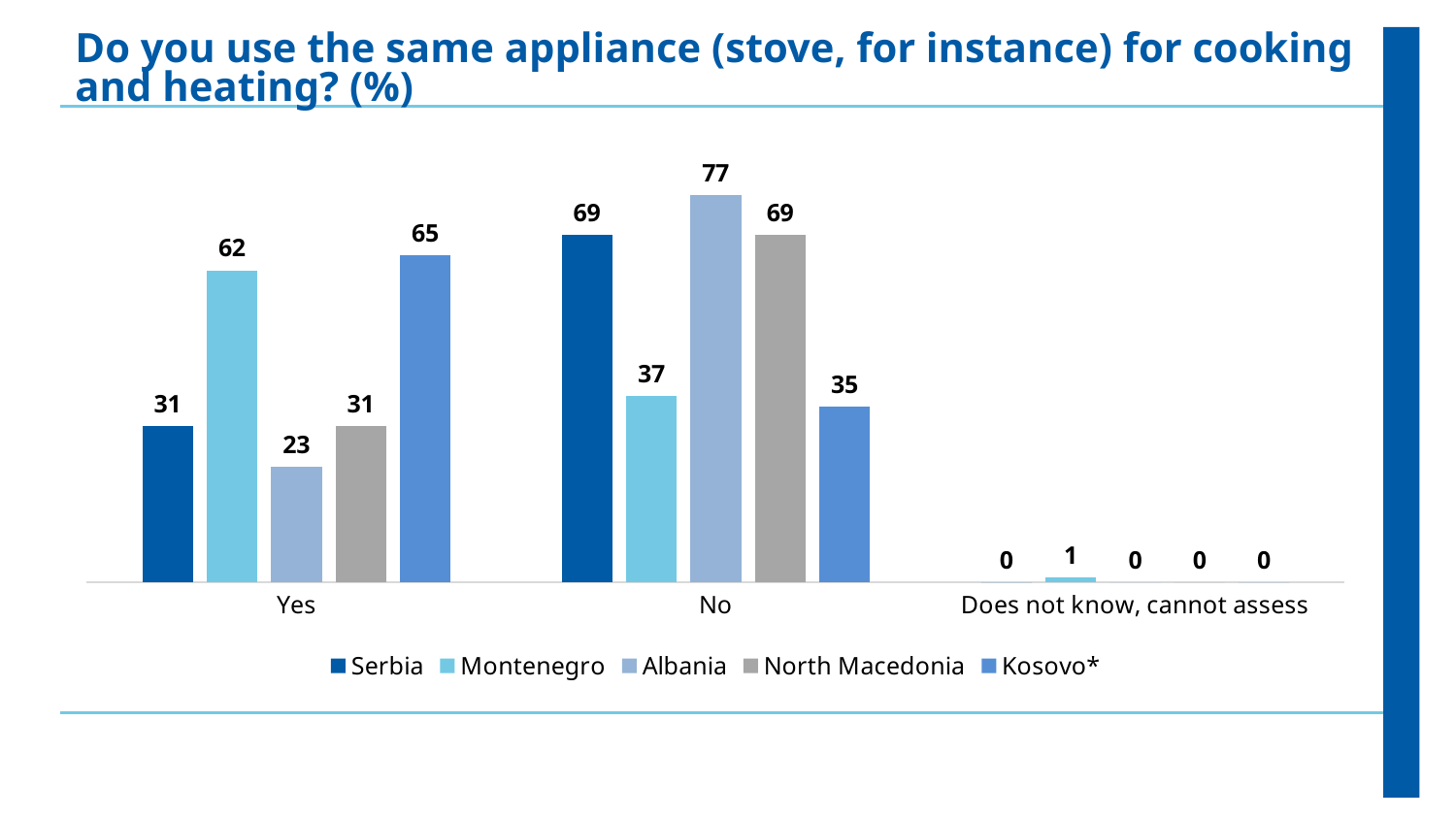
What is the value for Kosovo* in the "Yes" category? 65 How many response categories are shown on the x axis? 3 What is the value for North Macedonia in the "No" category? 69 What is the value for Albania in the "No" category? 77 What is the difference between the "No" and "Yes" values for Serbia? 38 Which country has the highest value in the "No" category? Albania What kind of chart is shown on the slide? Bar chart Which country has the lowest value in the "Yes" category? Albania Which country has a non-zero value in the "Does not know, cannot assess" category? Montenegro How many series does the legend list? 5 Which is larger: Montenegro's "Yes" value or Kosovo*'s "Yes" value? Kosovo* What is the value for Montenegro in the "Yes" category? 62